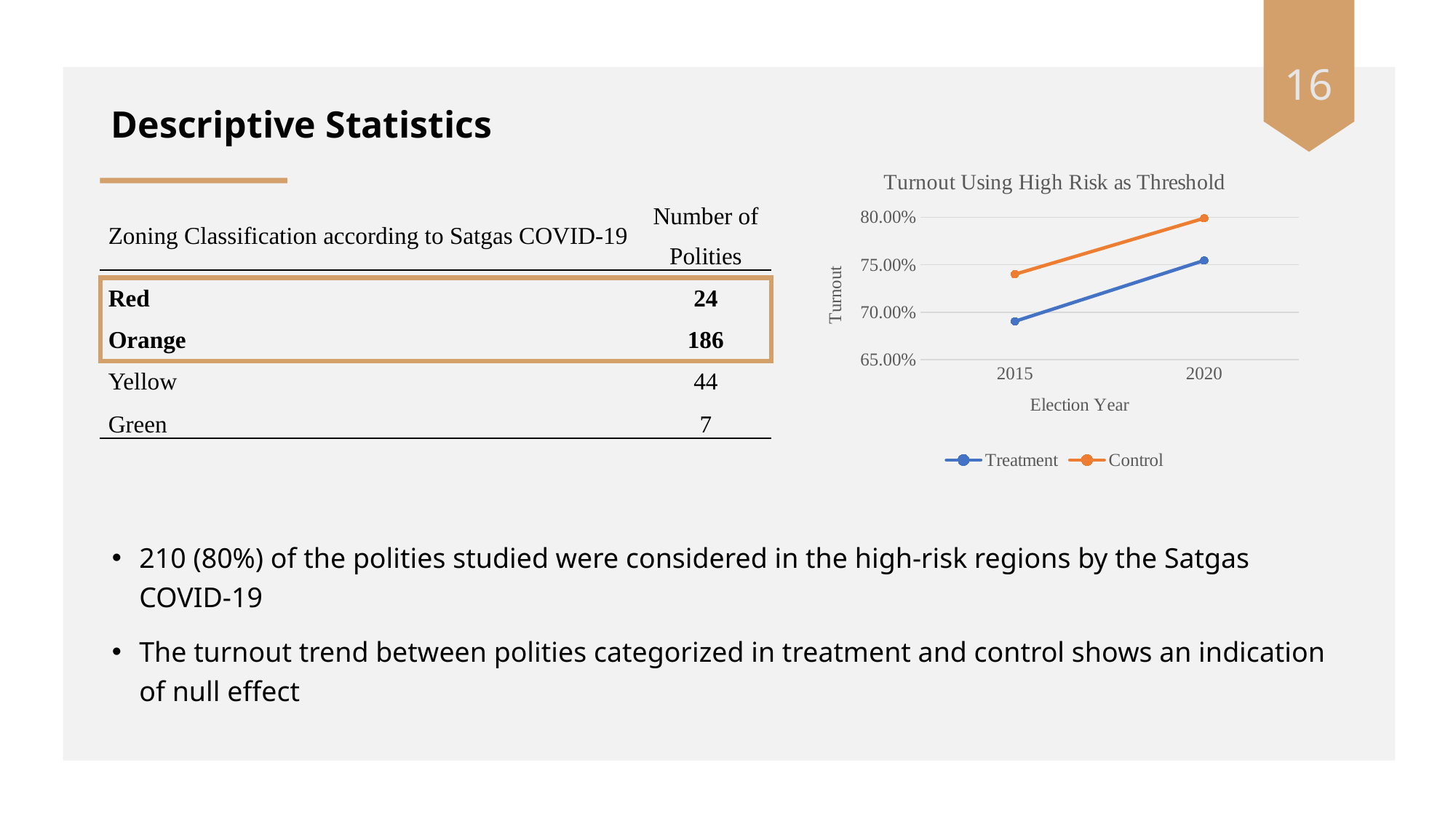
What kind of chart is shown on the slide? line chart In 2020, which series has the higher turnout, Treatment or Control? Control How many series does the chart's legend list? 2 In 2015, which series has the higher turnout, Treatment or Control? Control What is the title of the chart? Turnout Using High Risk as Threshold Is the Control turnout in 2015 greater or less than 75.00%? less Does the Treatment turnout rise or fall from 2015 to 2020? rise Does the Control turnout rise or fall from 2015 to 2020? rise Is the Control turnout in 2015 greater or less than 70.00%? greater Is the Treatment turnout in 2015 greater or less than 70.00%? less What is the label of the x axis of the chart? Election Year How many election years are plotted on the x axis of the chart? 2